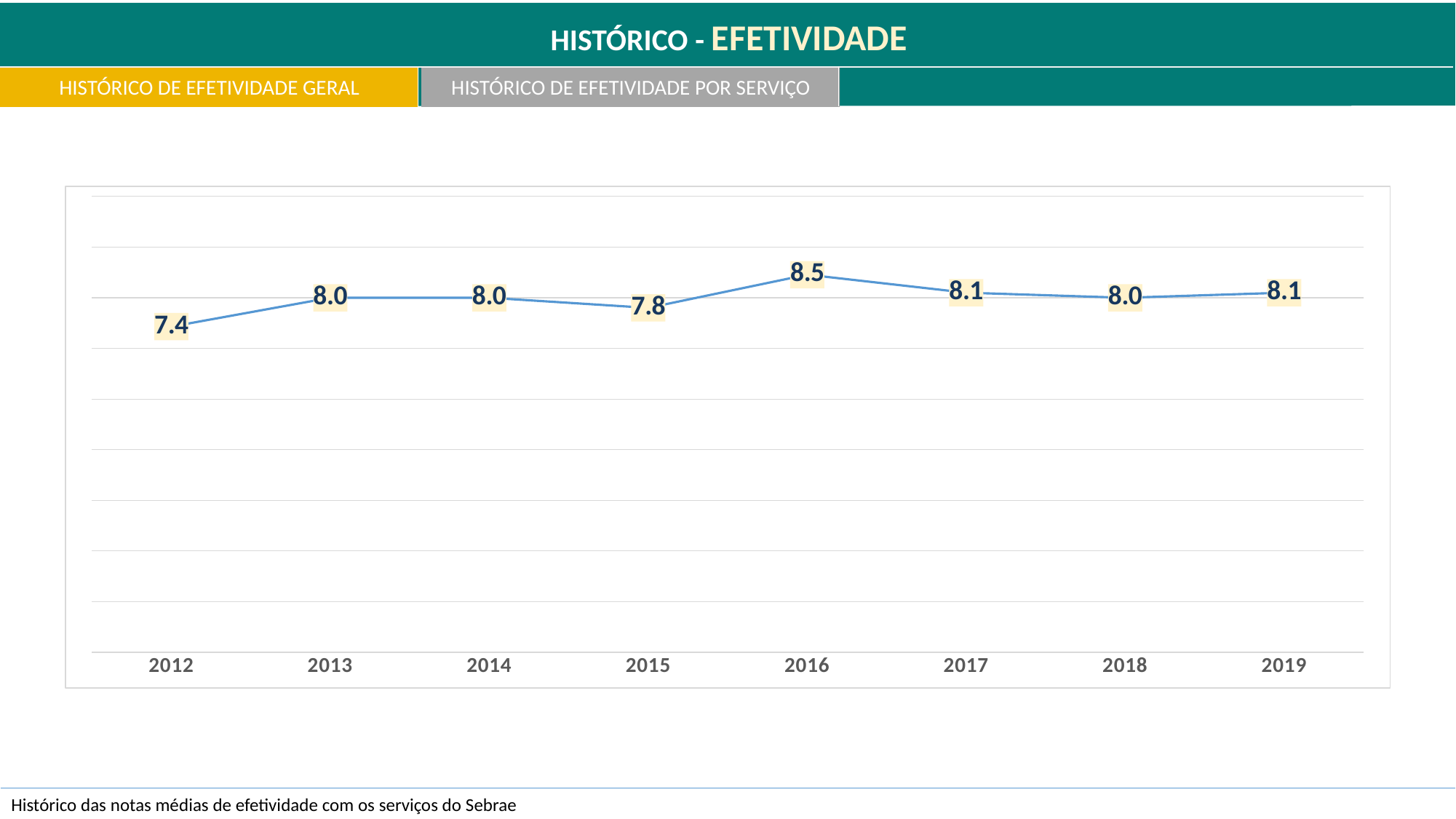
Which year has the highest value? 2016 What is the value for 2016? 8.5 What kind of chart is shown? Line chart What is the difference between the values for 2016 and 2012? 1.1 Which is larger, the value for 2015 or the value for 2016? 2016 What is the difference between the values for 2017 and 2015? 0.3 What is the value for 2019? 8.1 Does the value rise or fall from 2012 to 2013? Rise How many years are plotted on the chart? 8 What is the value for 2015? 7.8 What is the value for 2012? 7.4 Which year has the lowest value? 2012